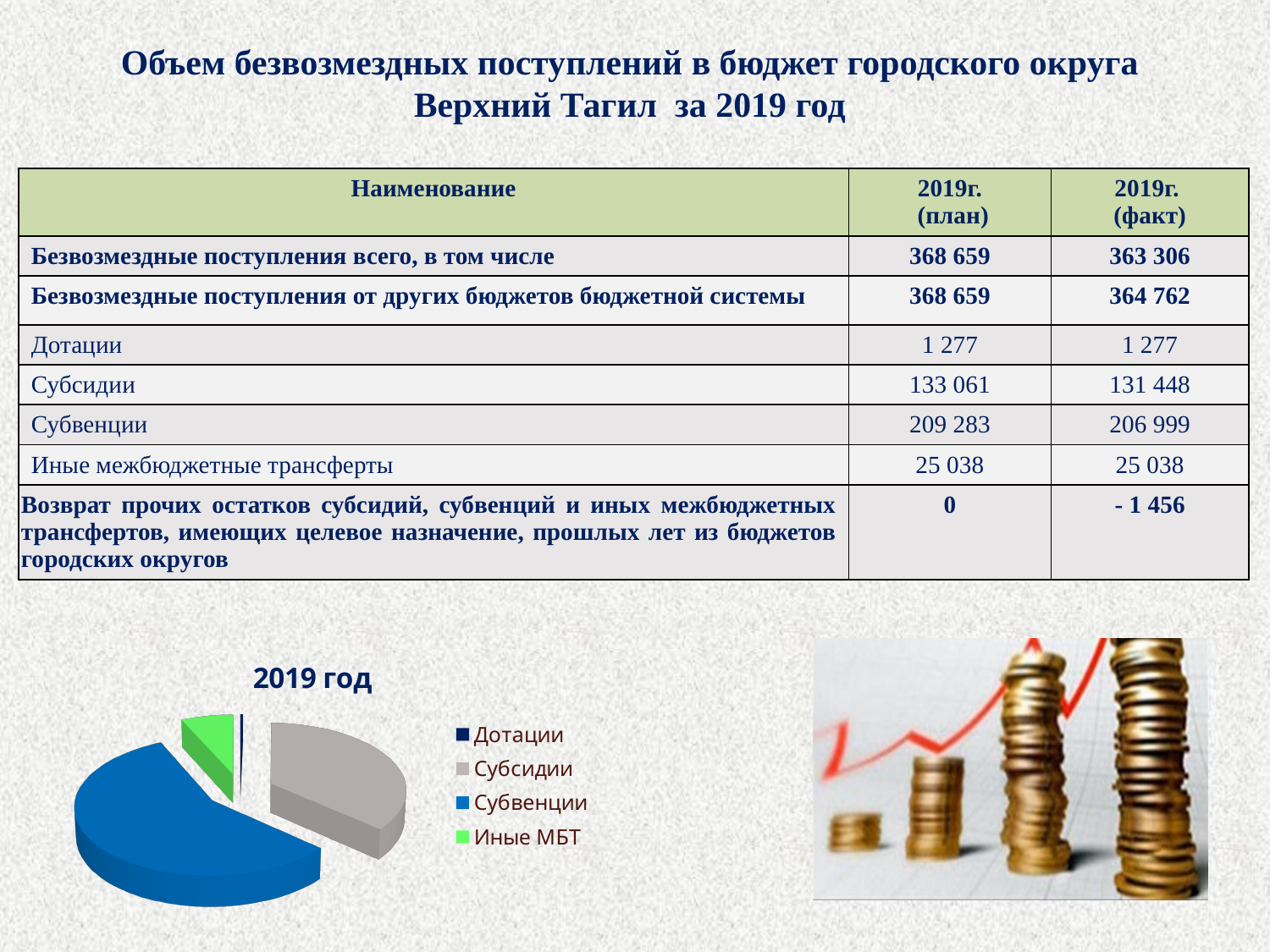
Which colour represents Субвенции in the pie chart? blue What kind of chart is shown on the slide under the heading "2019 год"? pie chart How many slices does the pie chart have? 4 Which category has the smallest slice in the pie chart? Дотации In the pie chart, which slice is larger: Субвенции or Субсидии? Субвенции In the pie chart, which slice is larger: Субсидии or Иные МБТ? Субсидии Which category has the largest slice in the pie chart? Субвенции How many entries does the legend of the pie chart list? 4 What is the title of the pie chart on the slide? 2019 год In the pie chart, which slice is larger: Иные МБТ or Дотации? Иные МБТ